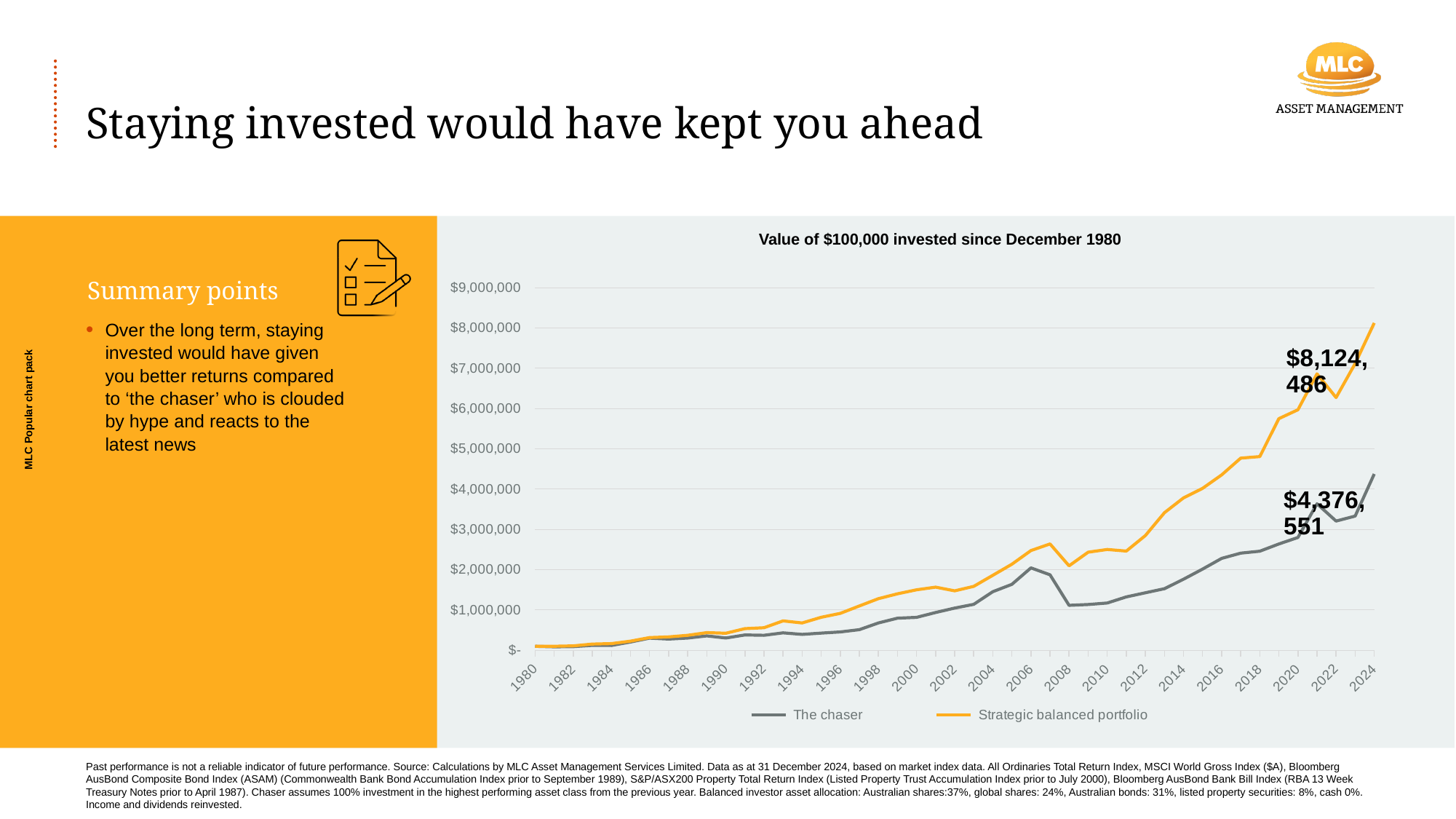
Do the values of the Strategic balanced portfolio series generally rise or fall from 1980 to 2024? Rise Which series ends higher in 2024, The chaser or the Strategic balanced portfolio? Strategic balanced portfolio What is the first year shown on the x axis of the chart? 1980 What is the difference between the labelled final values of the Strategic balanced portfolio and The chaser? $3,747,935 What is the title of the chart? Value of $100,000 invested since December 1980 Is the value for the Strategic balanced portfolio in 2020 greater or less than $5,000,000? greater Is the value for The chaser in 2016 greater or less than $3,000,000? less What is the labelled final value of the Strategic balanced portfolio series? $8,124,486 What colour is the line for the Strategic balanced portfolio? Orange What type of chart is shown on the slide? Line chart What is the labelled final value of The chaser series? $4,376,551 How many series does the chart's legend list? 2